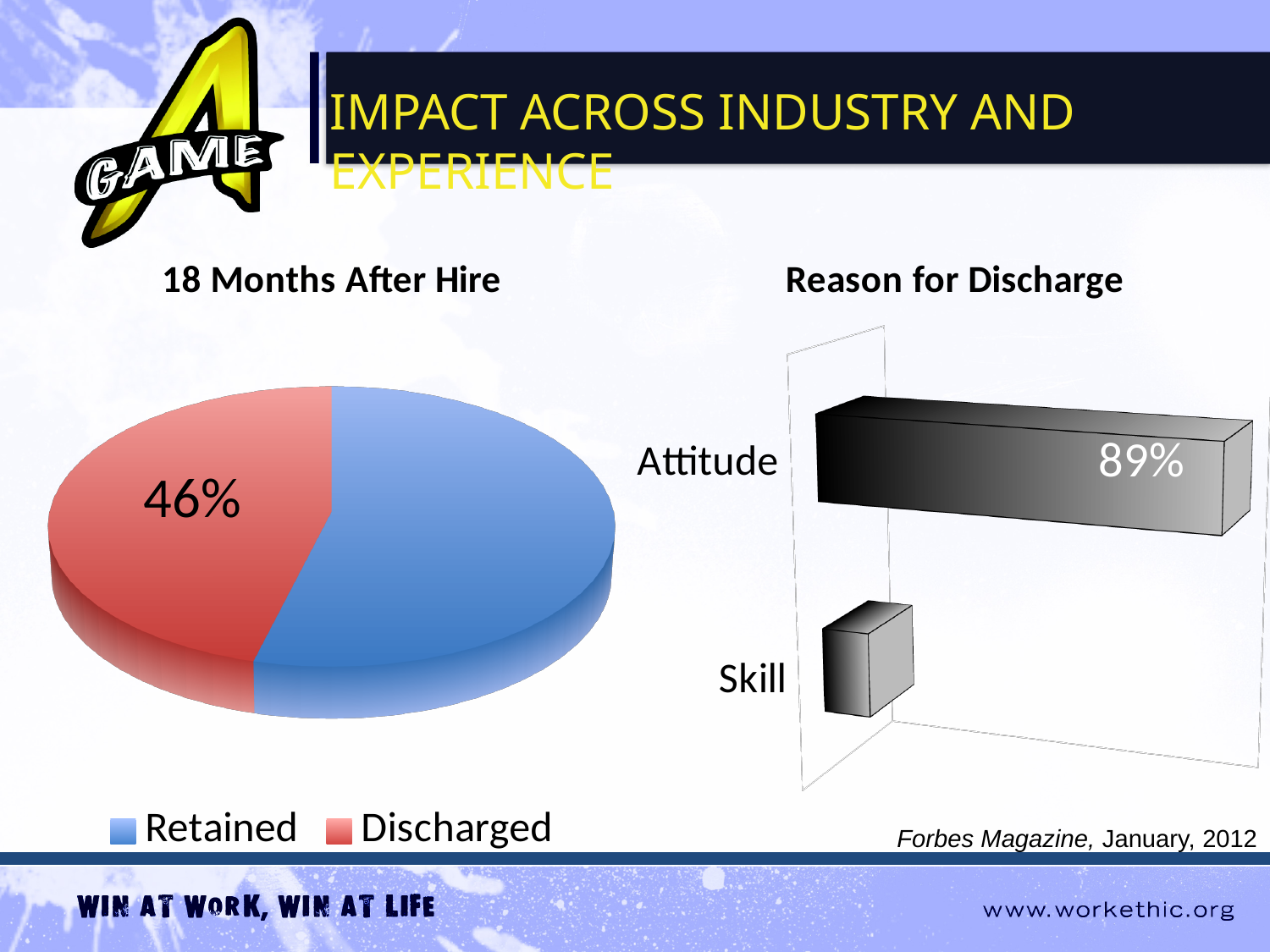
In the 18 Months After Hire pie chart, what colour represents Discharged? Red In the Reason for Discharge chart, which category has the highest value? Attitude What is the title of the chart on the right side of the slide? Reason for Discharge What kind of chart is the 18 Months After Hire chart? Pie chart In the 18 Months After Hire pie chart, what percentage is labelled for the Discharged slice? 46% How many categories are shown in the Reason for Discharge chart? 2 In the Reason for Discharge chart, what value is shown for Attitude? 89% What kind of chart is the Reason for Discharge chart? Bar chart In the Reason for Discharge chart, which category has the lowest value? Skill In the Reason for Discharge chart, which is larger, Attitude or Skill? Attitude In the 18 Months After Hire pie chart, which slice is larger, Retained or Discharged? Retained How many entries does the legend of the 18 Months After Hire chart list? 2